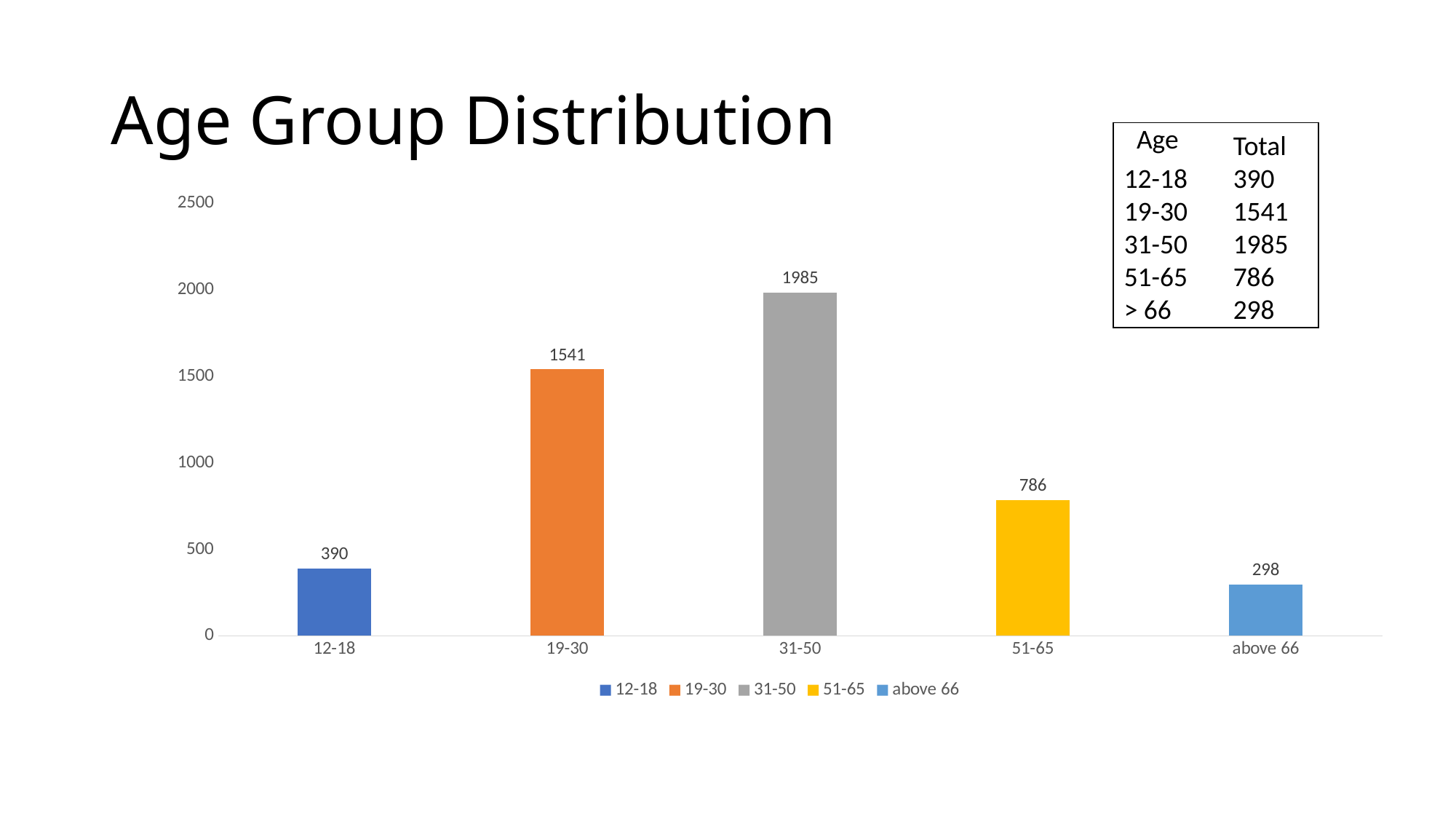
What kind of chart is shown on the slide? bar chart Which is larger, the value for 51-65 or the value for 12-18? 51-65 How many entries does the legend list? 5 What is the value for the 31-50 age group? 1985 What is the difference between the values for 31-50 and 19-30? 444 Which age group has the lowest value? above 66 Which age group has the highest value? 31-50 What is the difference between the values for 12-18 and above 66? 92 How many age groups are shown in the chart? 5 What is the value for the above 66 age group? 298 What is the value for the 51-65 age group? 786 Is the value for 19-30 greater or less than 1500? greater